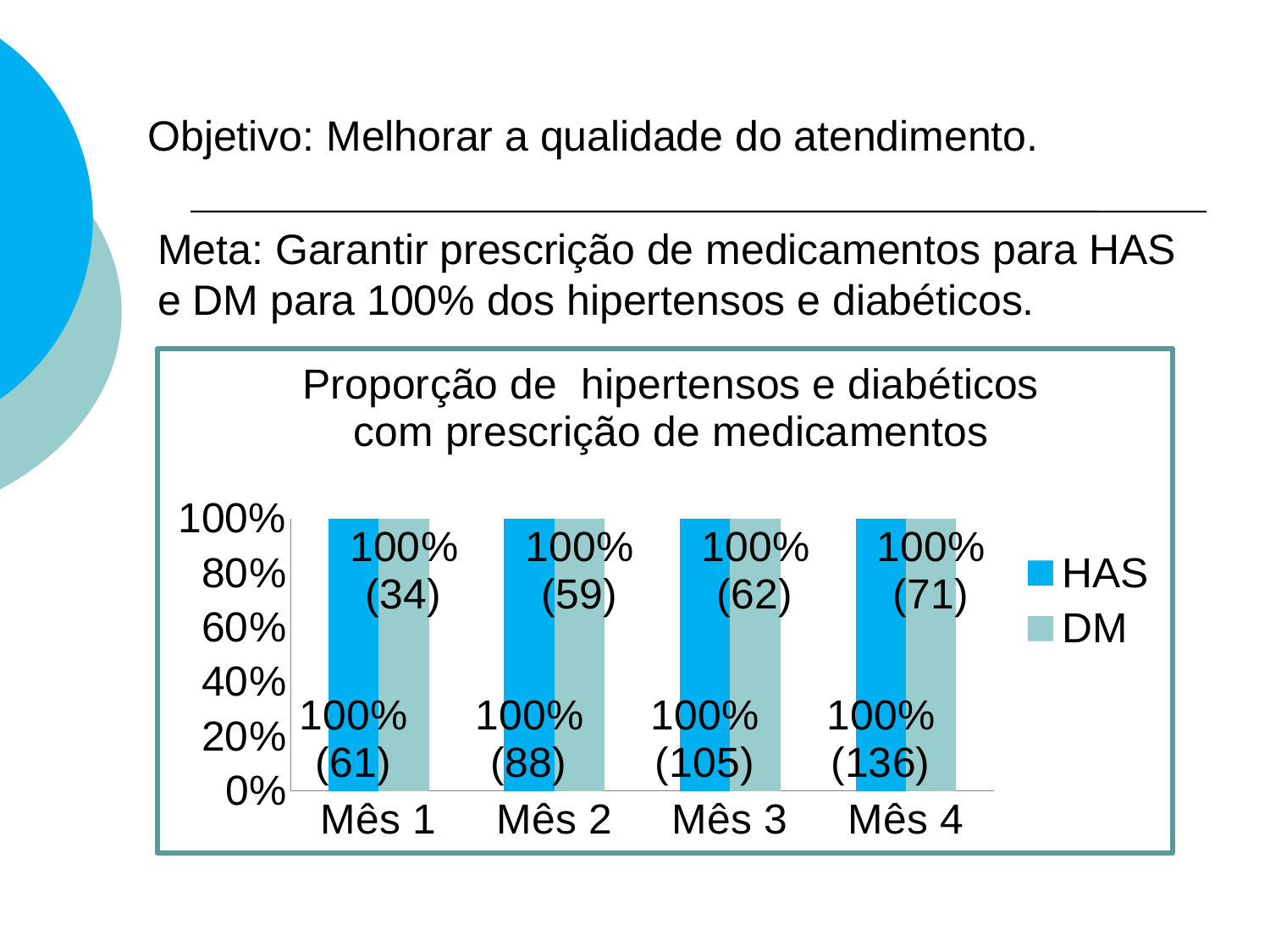
What type of chart is shown on the slide? bar chart How many series does the legend list? 2 What number in parentheses is shown for HAS in Mês 1? 61 What number in parentheses is shown for HAS in Mês 4? 136 What is the percentage value for DM in Mês 1? 100% What number in parentheses is shown for DM in Mês 2? 59 How many months (categories) are shown on the x axis? 4 What is the title of the chart? Proporção de hipertensos e diabéticos com prescrição de medicamentos What is the difference between the HAS count in Mês 4 (136) and the HAS count in Mês 1 (61)? 75 Do the percentage values for HAS rise, fall, or stay the same from Mês 1 to Mês 4? stay the same Which series is shown in the lighter blue-green colour in the legend? DM What is the percentage value for HAS in Mês 3? 100%